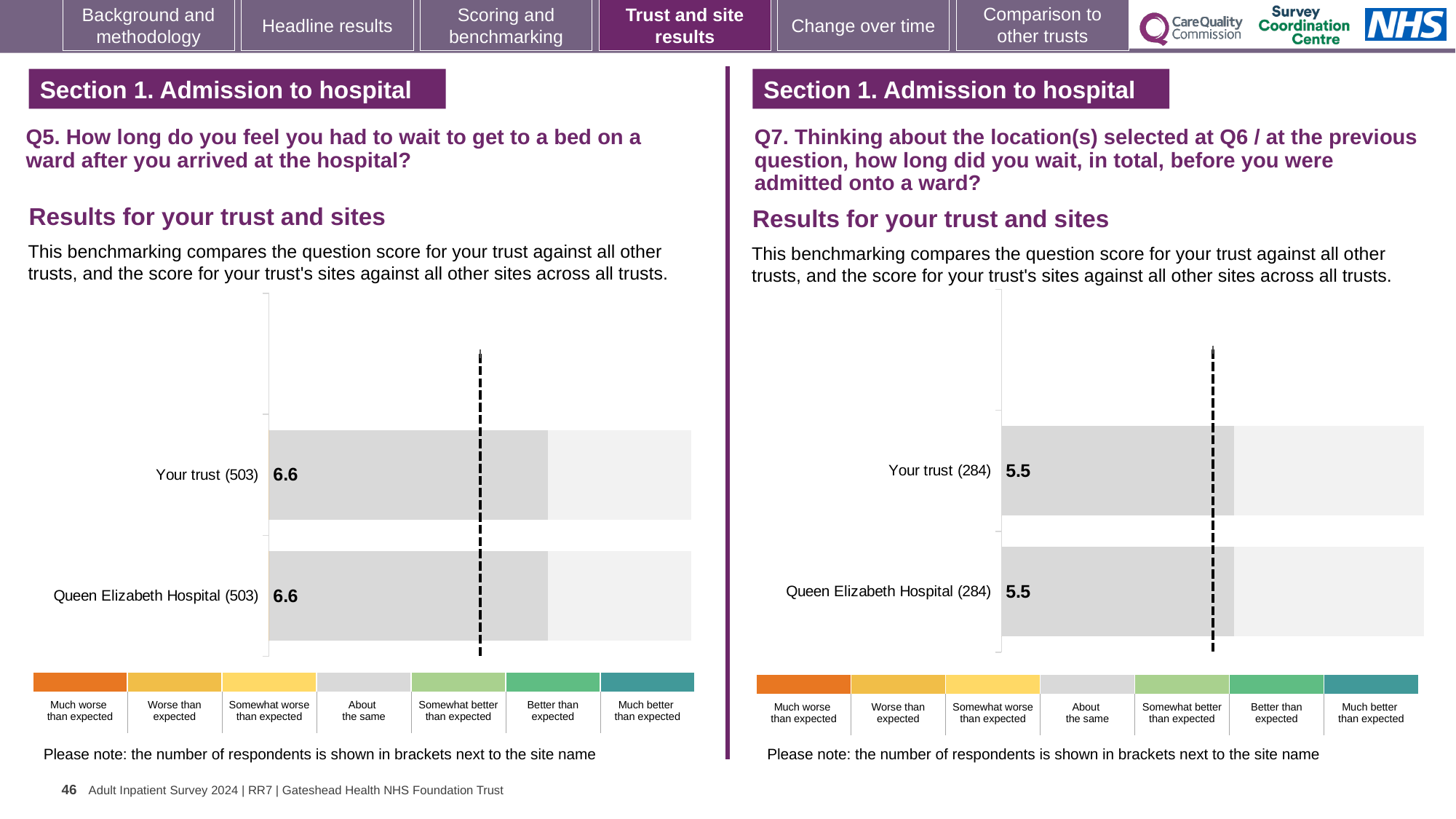
In the Q5 chart on the left, what is the score for Your trust? 6.6 In the Q5 chart on the left, how many respondents are shown in brackets for Your trust? 503 How many bars are plotted in the Q5 chart on the left? 2 What kind of chart is used for the Q7 results on the right? Bar chart In the Q5 chart on the left, what is the difference between the score for Your trust and the score for Queen Elizabeth Hospital? 0 In the Q7 chart on the right, how many respondents are shown in brackets for Queen Elizabeth Hospital? 284 In the Q7 chart on the right, what is the score for Your trust? 5.5 In the Q7 chart on the right, what is the difference between the score for Your trust and the score for Queen Elizabeth Hospital? 0 In the Q5 chart on the left, what is the score for Queen Elizabeth Hospital? 6.6 In the Q7 chart on the right, what is the score for Queen Elizabeth Hospital? 5.5 In the Q7 chart on the right, which rating category does the colour key show in dark orange at the far left? Much worse than expected How many rating categories does the colour key below the Q5 chart on the left list? 7